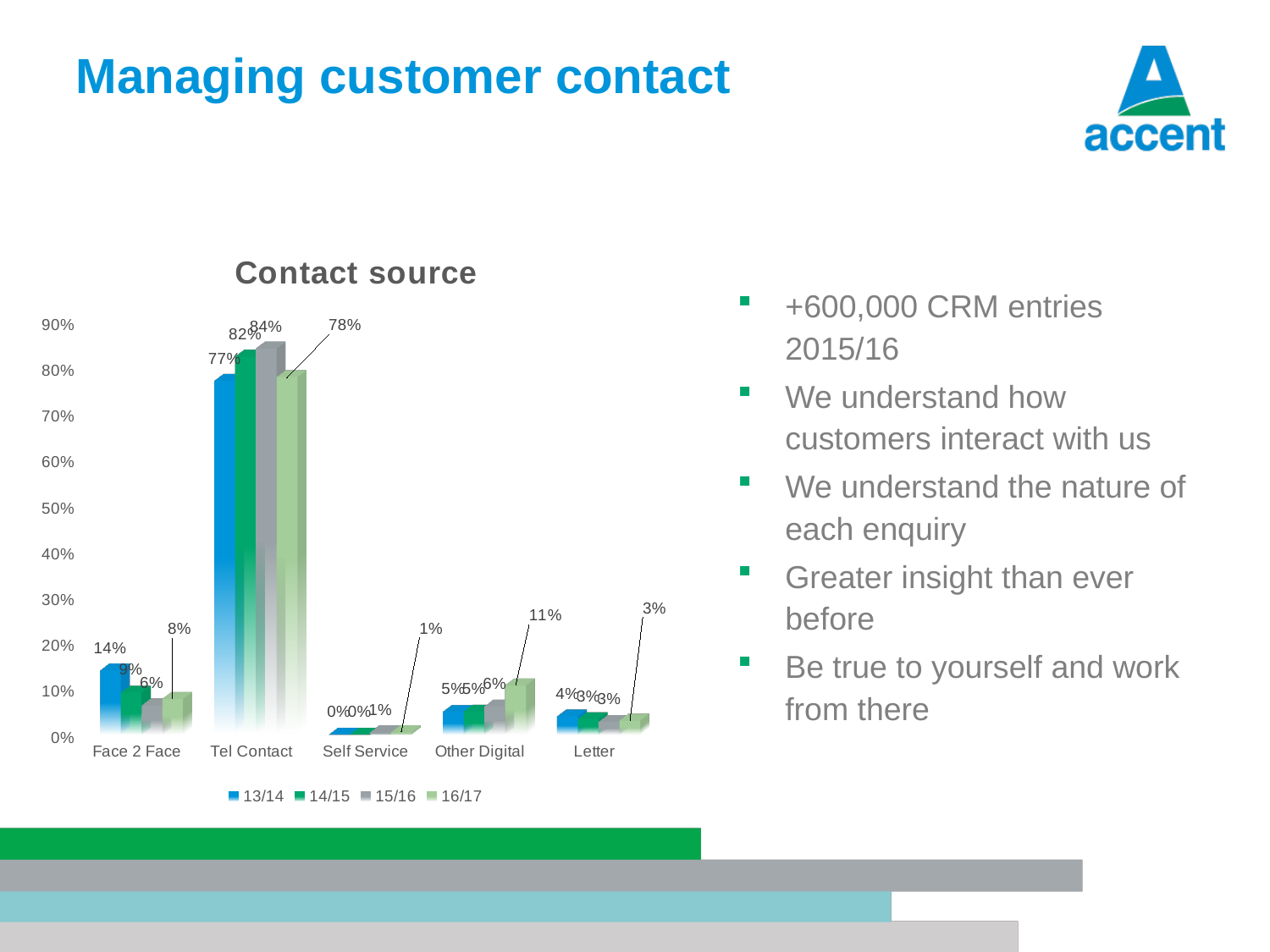
In the Contact source chart, which contact source has the highest value in 16/17? Tel Contact In the Contact source chart, do the Other Digital values rise or fall from 13/14 to 16/17? Rise In the Contact source chart, what is the difference between the Tel Contact values for 15/16 and 13/14? 7 percentage points What kind of chart is the Contact source chart? Bar chart In the Contact source chart, which is larger for Face 2 Face: the 13/14 value or the 16/17 value? 13/14 In the Contact source chart, what is the value for Tel Contact in 15/16? 84% In the Contact source chart, what is the value for Face 2 Face in 13/14? 14% How many series does the legend of the Contact source chart list? 4 In the Contact source chart, what is the value for Other Digital in 16/17? 11% In the Contact source chart, which contact source has the lowest value in 13/14? Self Service In the Contact source chart, what is the value for Tel Contact in 13/14? 77% In the Contact source chart, how many contact source categories are shown on the x axis? 5